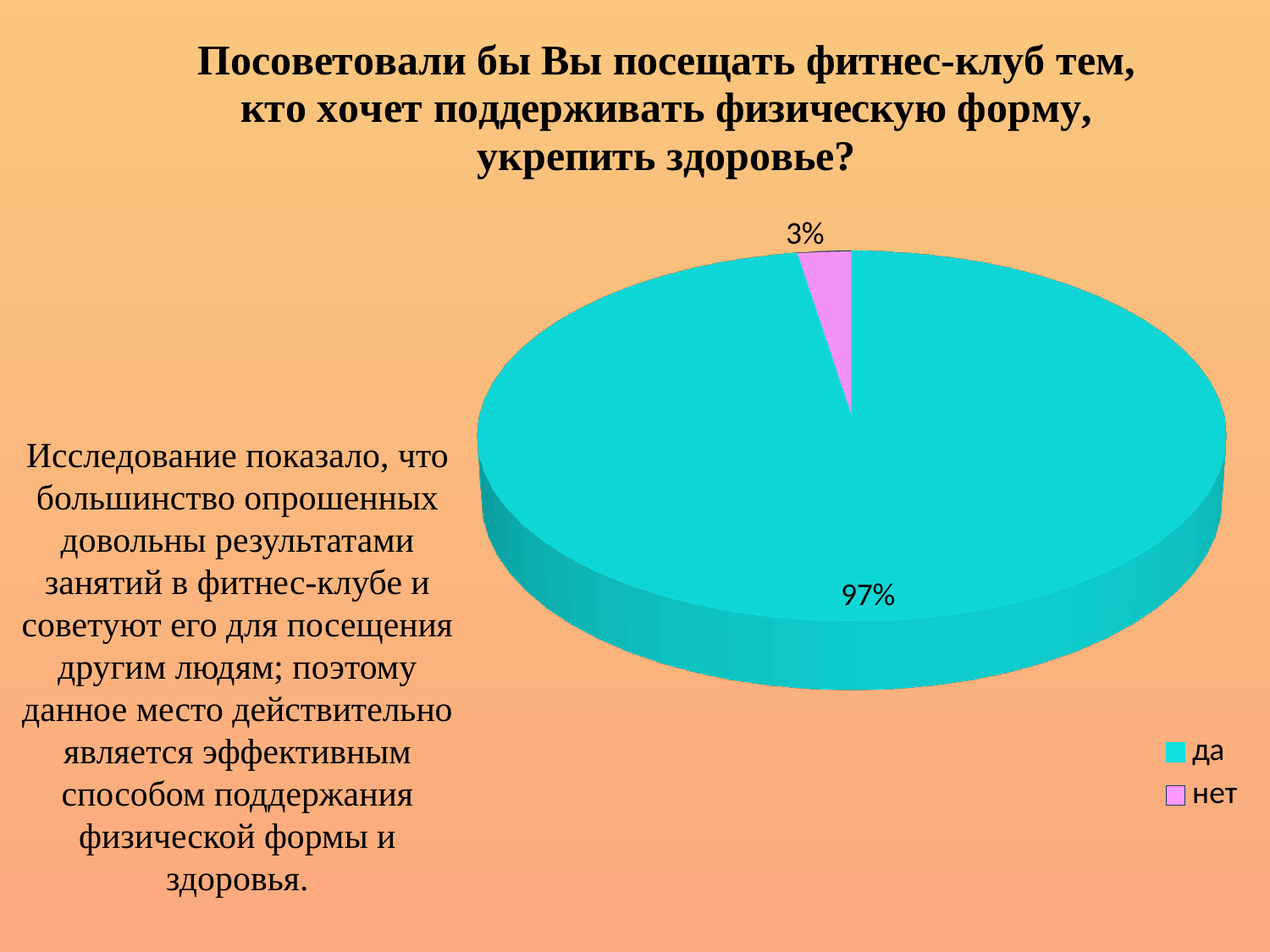
Which is larger, the "да" slice or the "нет" slice? да Which category has the largest slice of the pie? да What share of the pie does the "нет" slice represent? 3% How many categories does the pie chart show? 2 How many entries does the legend list? 2 What colour is the "нет" slice in the pie chart? pink What kind of chart is shown on the slide? pie chart What share of the pie does the "да" slice represent? 97% What is the difference in percentage points between the "да" and "нет" slices? 94 What colour is the "да" slice in the pie chart? turquoise Which category has the smallest slice of the pie? нет